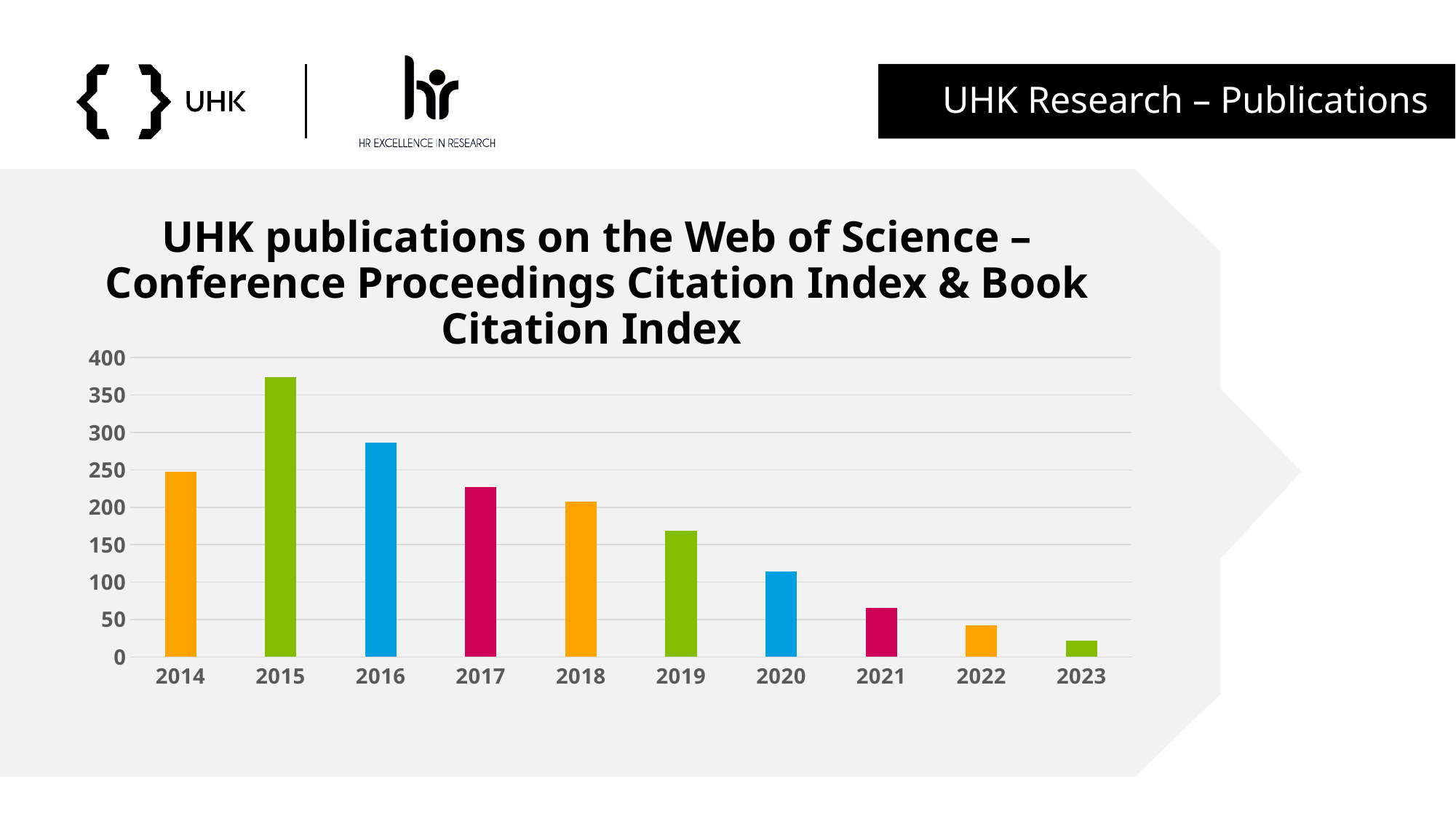
Which year has the lowest number of publications? 2023 What is the title of the chart? UHK publications on the Web of Science – Conference Proceedings Citation Index & Book Citation Index Is the value for 2020 greater or less than 100? greater Is the value for 2015 greater or less than 350? greater How many years are shown on the x axis of the chart? 10 Which is larger, the value for 2019 or the value for 2021? 2019 Which year has the highest number of publications? 2015 Is the value for 2022 greater or less than 50? less What kind of chart is shown on the slide? bar chart Which is larger, the value for 2014 or the value for 2017? 2014 From 2015 to 2023, do the values rise or fall along the x axis? fall